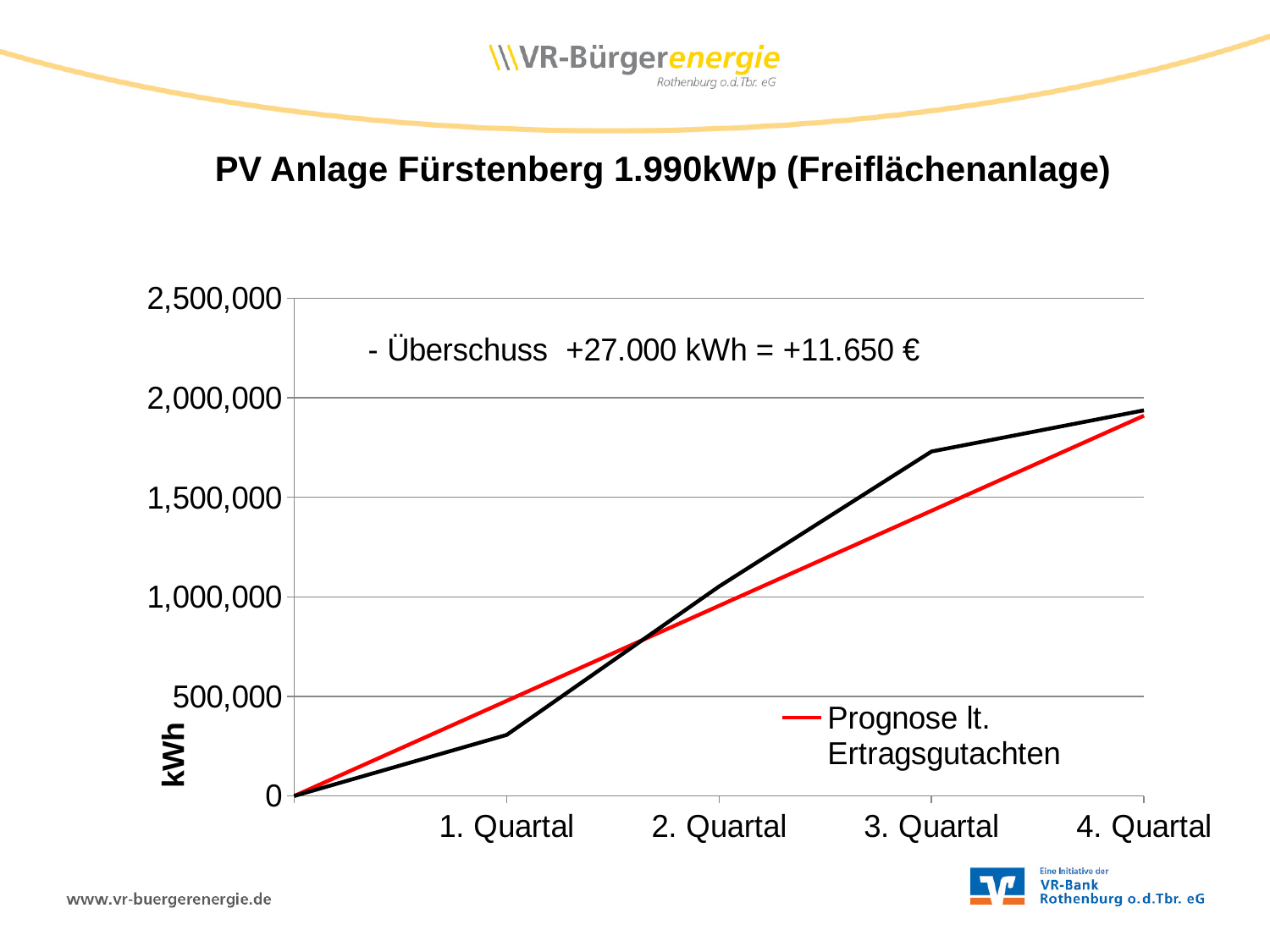
Is the value of the black line at 1. Quartal greater or less than 500,000? less What is the name of the series shown in the legend? Prognose lt. Ertragsgutachten Is the value of the black line at 4. Quartal greater or less than 2,000,000? less How many series does the chart legend list? 1 How many quarters are labeled on the x axis? 4 Is the value of the red Prognose line at 3. Quartal greater or less than 1,000,000? greater What kind of chart is shown on the slide? line chart At 1. Quartal, which line is higher: the red Prognose line or the black line? the red Prognose line Do the lines rise or fall from left to right along the x axis? rise What is the label of the y axis? kWh At 3. Quartal, which line is higher: the red Prognose line or the black line? the black line